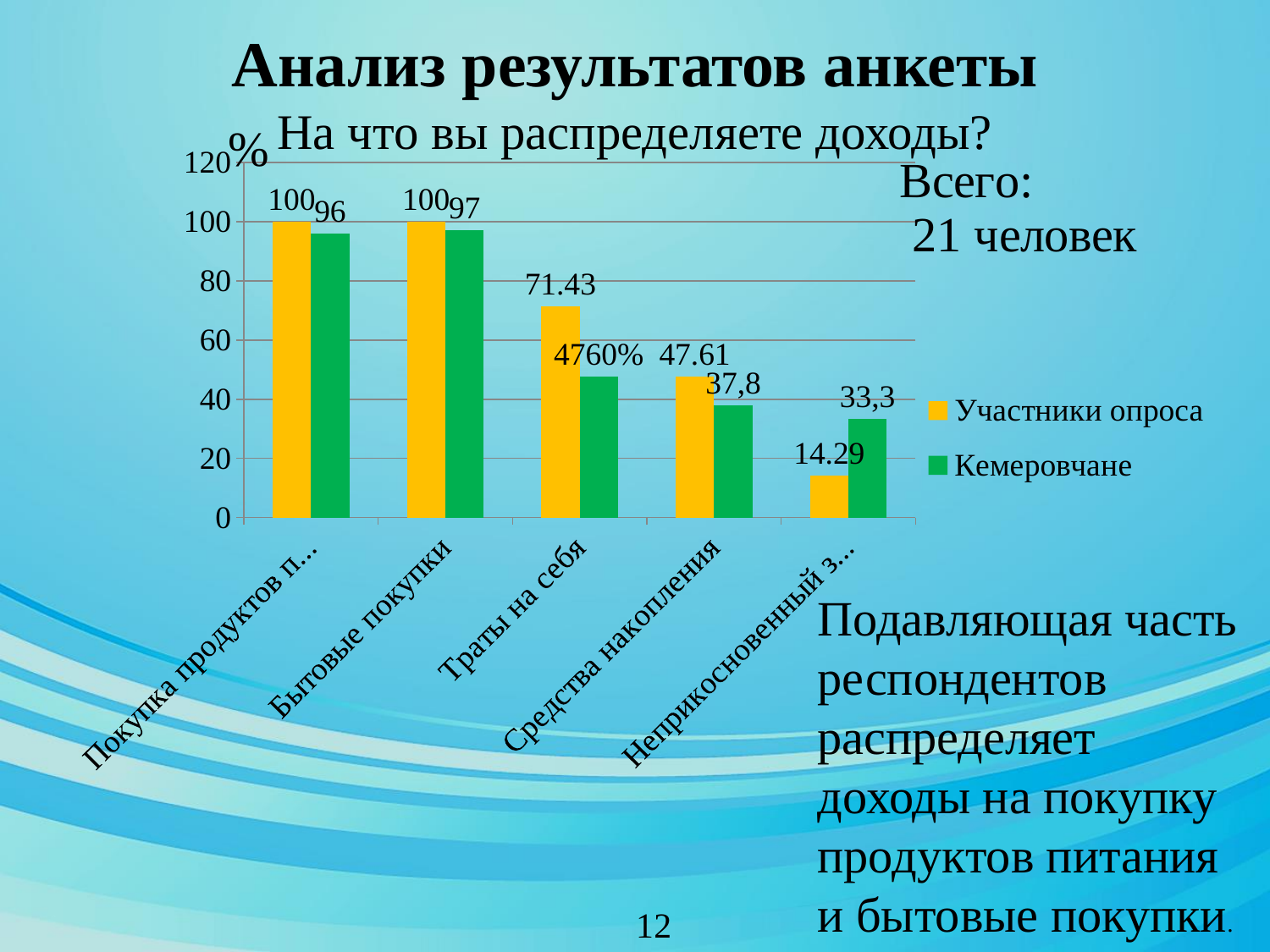
What kind of chart is shown on the slide? bar chart In the category Траты на себя, which series has the larger value: Участники опроса or Кемеровчане? Участники опроса What is the value for Кемеровчане in the category Средства накопления? 37,8 What is the lowest value plotted for the series Участники опроса? 14.29 Is the value for Кемеровчане in the category Траты на себя greater or less than 60? less What is the value for Участники опроса in the category Бытовые покупки? 100 What is the value for Участники опроса in the category Траты на себя? 71.43 What is the value for Кемеровчане in the category Бытовые покупки? 97 How many series does the chart legend list? 2 How many categories are shown on the x axis of the chart? 5 What is the difference between Участники опроса and Кемеровчане in the category Бытовые покупки? 3 Do the values for Участники опроса rise or fall from left to right along the x axis? fall